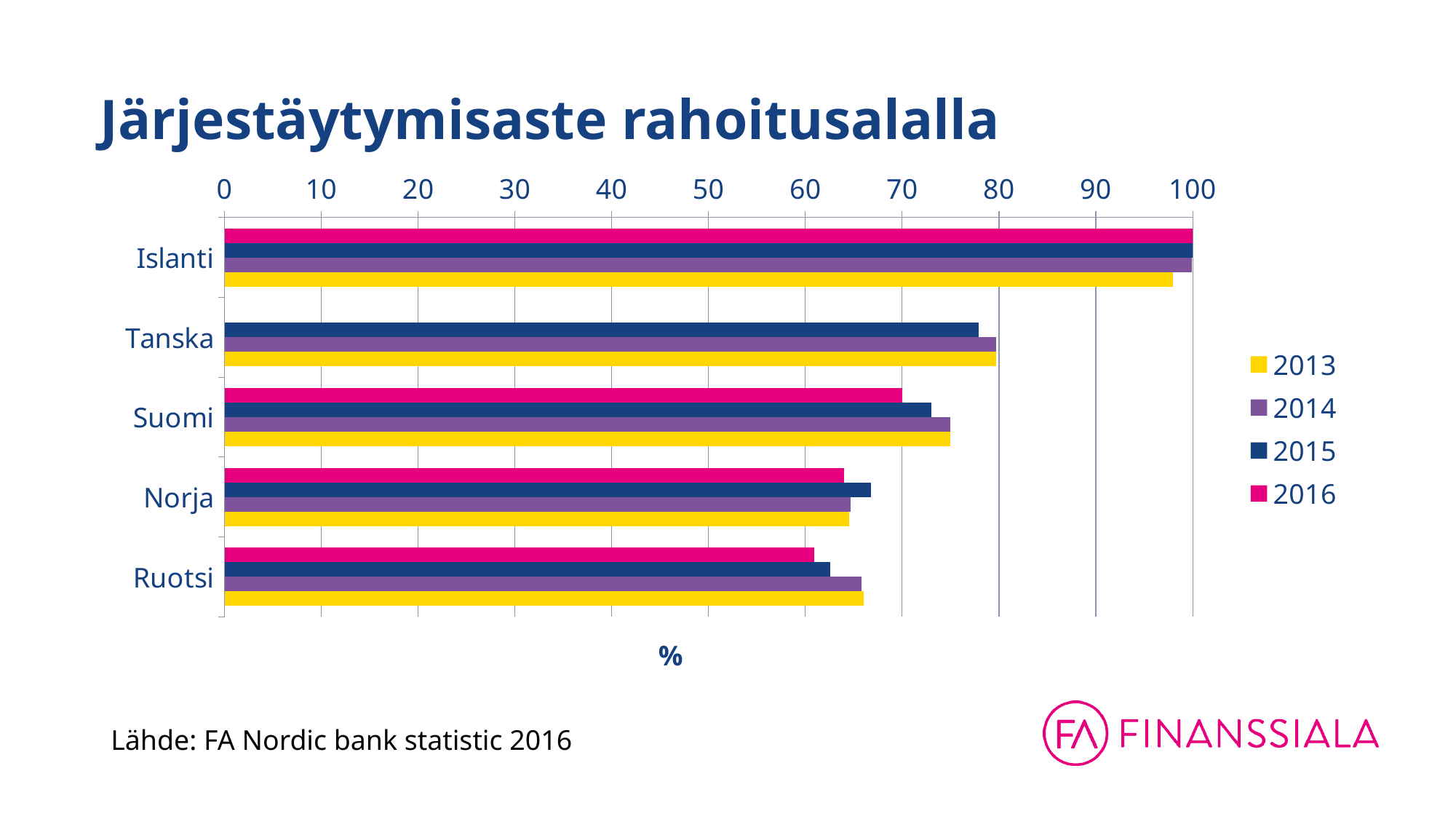
Which country has no bar for 2016? Tanska How many series does the legend list? 4 Which country has the highest value for 2016? Islanti Is the value for Suomi in 2016 greater or less than 60? greater What kind of chart is shown on the slide? bar chart How many countries are shown on the chart? 5 What is the title of the chart? Järjestäytymisaste rahoitusalalla Is the value for Ruotsi in 2016 greater or less than 70? less Which is larger, the 2016 value for Norja or the 2016 value for Ruotsi? Norja Is the value for Tanska in 2013 greater or less than 70? greater Which country has the lowest value for 2016? Ruotsi Which is larger, the 2015 value for Tanska or the 2015 value for Suomi? Tanska